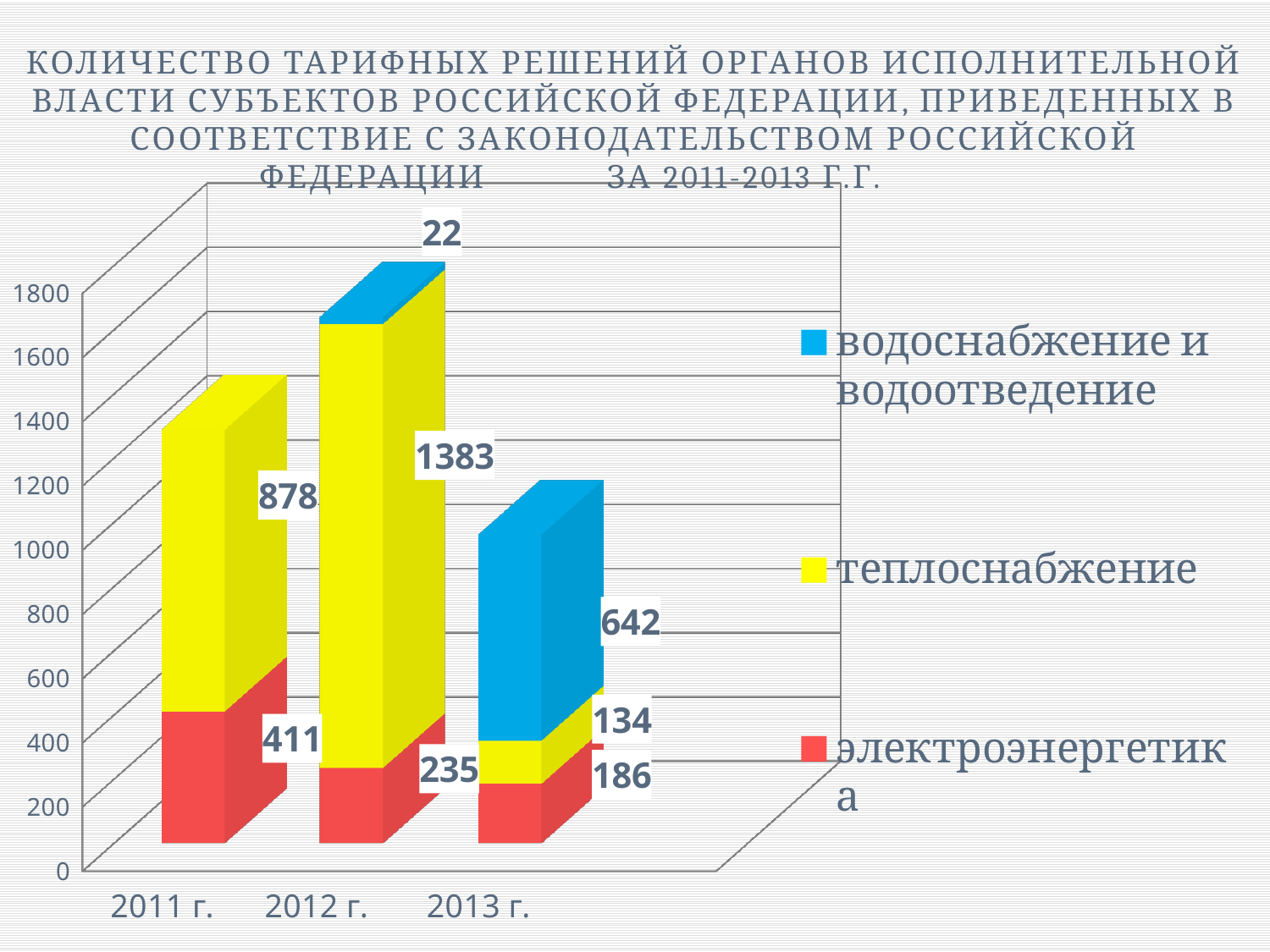
In which year is the электроэнергетика value lowest? 2013 г. What is the difference between the теплоснабжение values for 2012 г. and 2011 г.? 505 How many year categories are shown on the x axis? 3 How many series does the legend list? 3 What kind of chart is shown on the slide? stacked bar chart Which is larger in 2013 г.: the value for водоснабжение и водоотведение or the value for электроэнергетика? водоснабжение и водоотведение What is the value for электроэнергетика in 2011 г.? 411 What is the value for водоснабжение и водоотведение in 2013 г.? 642 What is the value for водоснабжение и водоотведение in 2012 г.? 22 What is the total of the stacked bar for 2013 г.? 962 What is the value for теплоснабжение in 2012 г.? 1383 In which year is the теплоснабжение value highest? 2012 г.